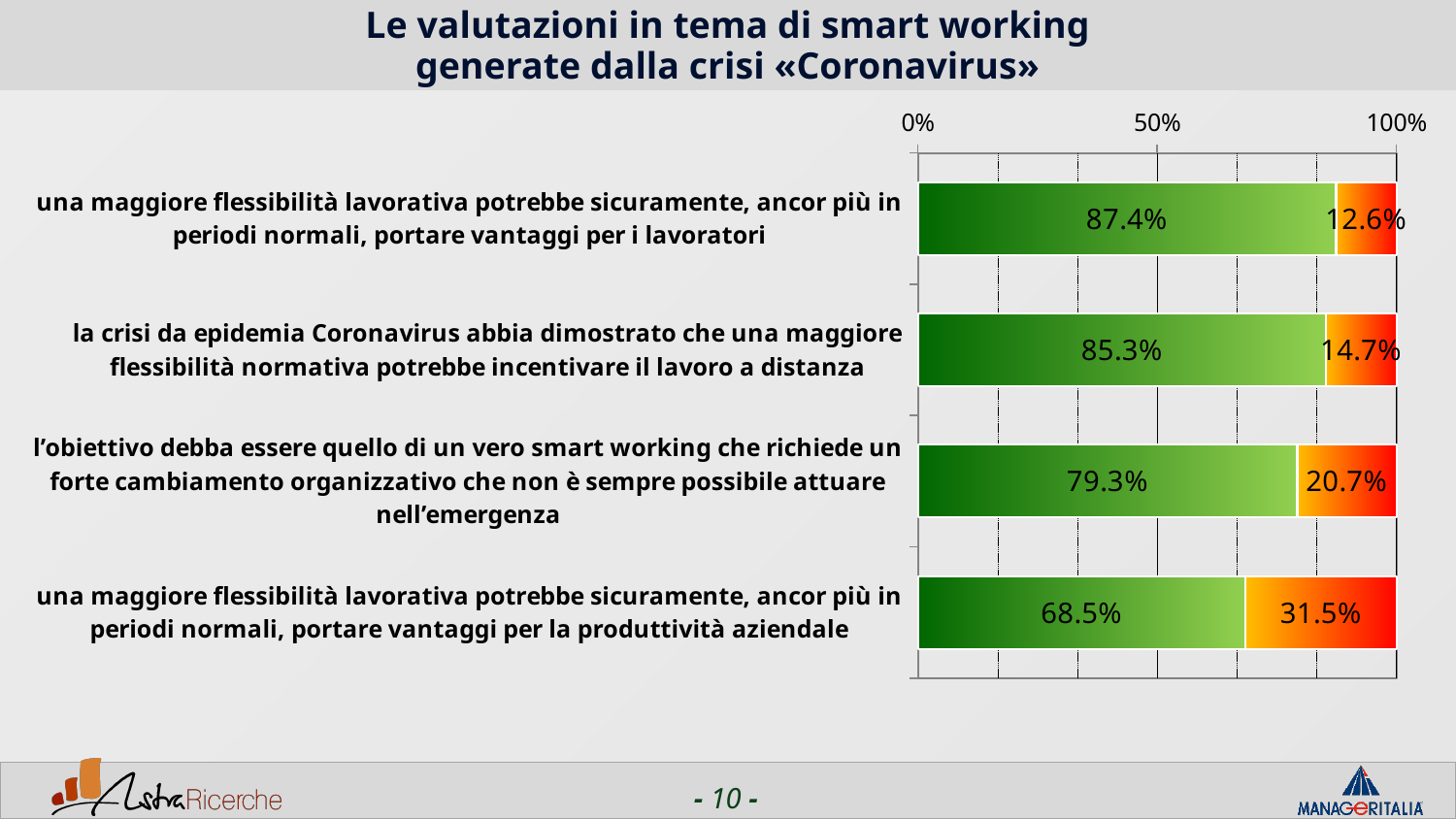
Which statement has the highest green segment value? una maggiore flessibilità lavorativa potrebbe sicuramente, ancor più in periodi normali, portare vantaggi per i lavoratori Which is larger: the orange segment for the 'lavoro a distanza' statement or the orange segment for the 'vero smart working' statement? the 'vero smart working' statement (20.7%) What is the total of the two segments in the bar for the 'vero smart working' statement? 100% What is the orange segment value for the statement about flexibility bringing advantages 'per la produttività aziendale'? 31.5% What is the maximum value shown on the horizontal axis? 100% What is the difference between the green segment values for the 'vantaggi per i lavoratori' statement and the 'vantaggi per la produttività aziendale' statement? 18.9% What kind of chart is shown on the slide? bar chart What is the green segment value for the statement that the Coronavirus crisis showed that greater regulatory flexibility could encourage remote work? 85.3% How many categories (statements) are plotted in the chart? 4 What is the green segment value for the statement about flexibility bringing advantages 'per i lavoratori'? 87.4% Which statement has the lowest green segment value? una maggiore flessibilità lavorativa potrebbe sicuramente, ancor più in periodi normali, portare vantaggi per la produttività aziendale What is the orange segment value for the statement about the goal being a true smart working requiring strong organizational change? 20.7%